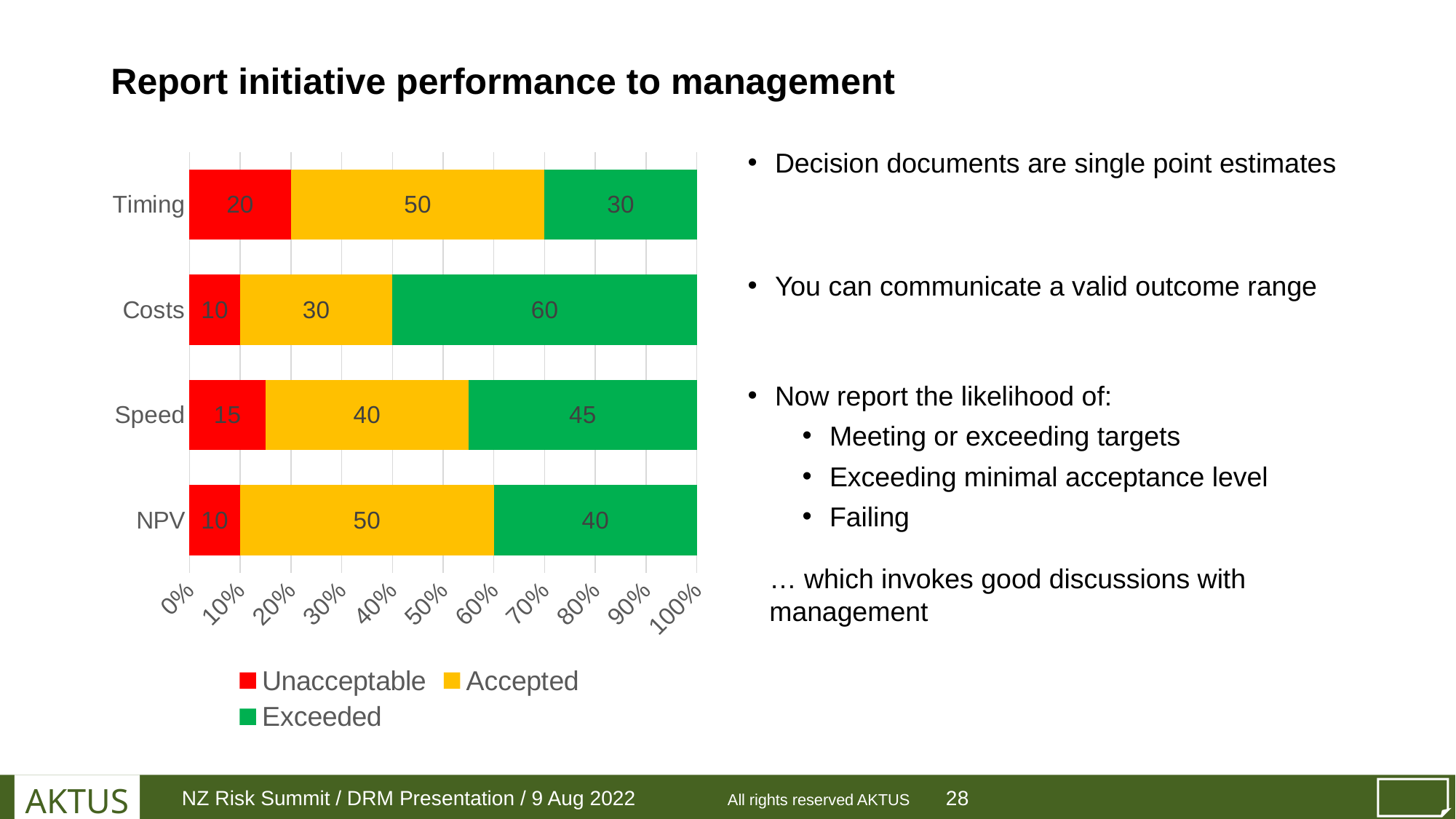
What is the total of the stacked bar for Speed? 100 What kind of chart is shown on the slide? Stacked bar chart Which colour represents the Unacceptable series? Red How many series does the legend list? 3 Which is larger, the Exceeded value for Speed or the Exceeded value for NPV? Speed Which category has the lowest Exceeded value? Timing What is the Exceeded value for Costs? 60 Which category has the highest Exceeded value? Costs How many categories are shown on the chart? 4 What is the Accepted value for Timing? 50 What is the Unacceptable value for Speed? 15 What is the difference between the Accepted values for NPV and Costs? 20